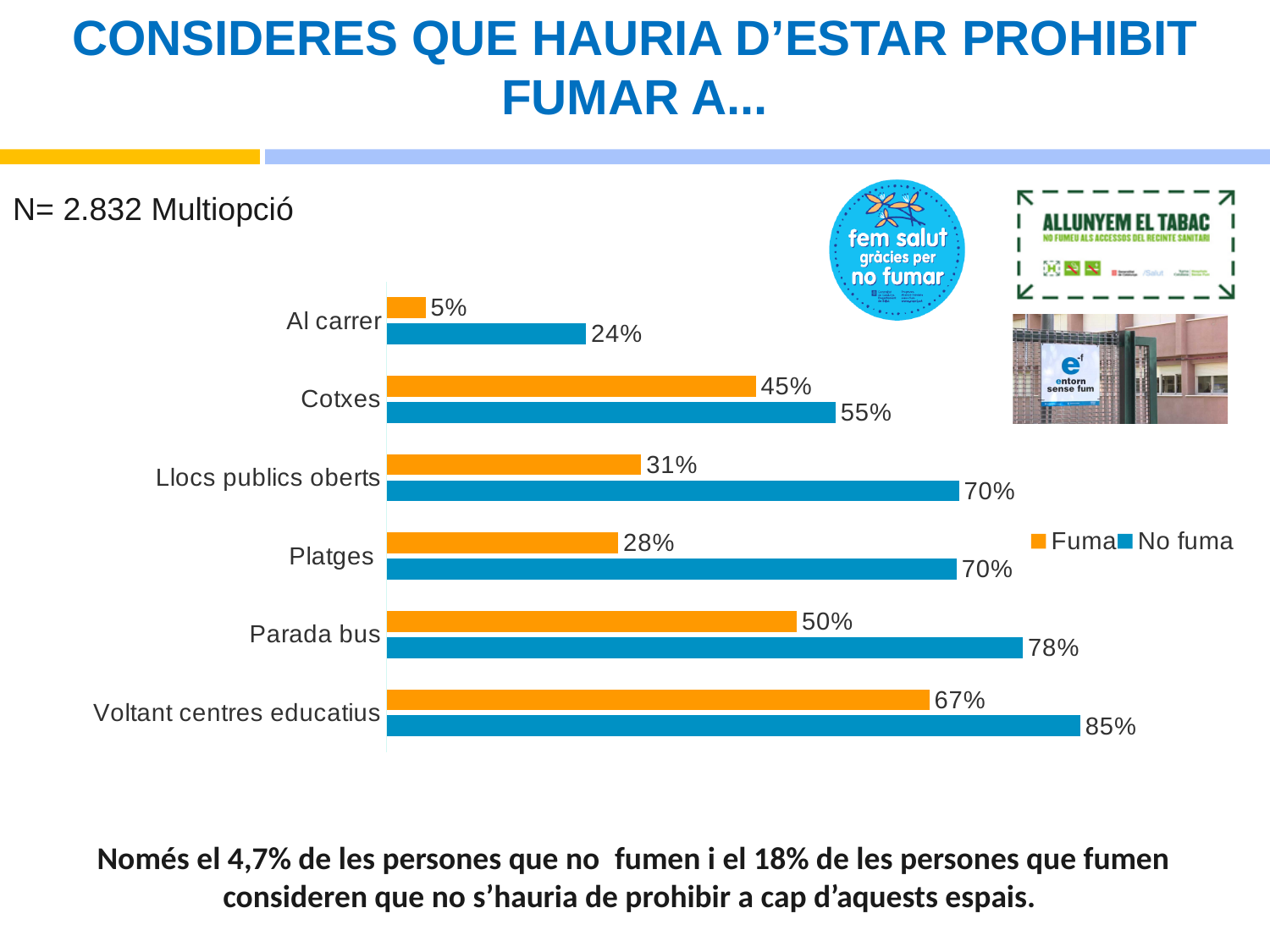
Which colour represents the 'Fuma' series in the legend? Orange What is the 'No fuma' value for Voltant centres educatius? 85% What is the difference between the 'No fuma' and 'Fuma' values for Llocs publics oberts? 39% Which category has the highest 'No fuma' value? Voltant centres educatius Which category has the lowest 'Fuma' value? Al carrer Which is larger for Cotxes: the 'Fuma' value or the 'No fuma' value? No fuma How many categories are shown on the chart? 6 What kind of chart is shown on the slide? Bar chart What is the 'Fuma' value for Al carrer? 5% How many series does the legend list? 2 What is the 'Fuma' value for Parada bus? 50% What is the 'No fuma' value for Platges? 70%